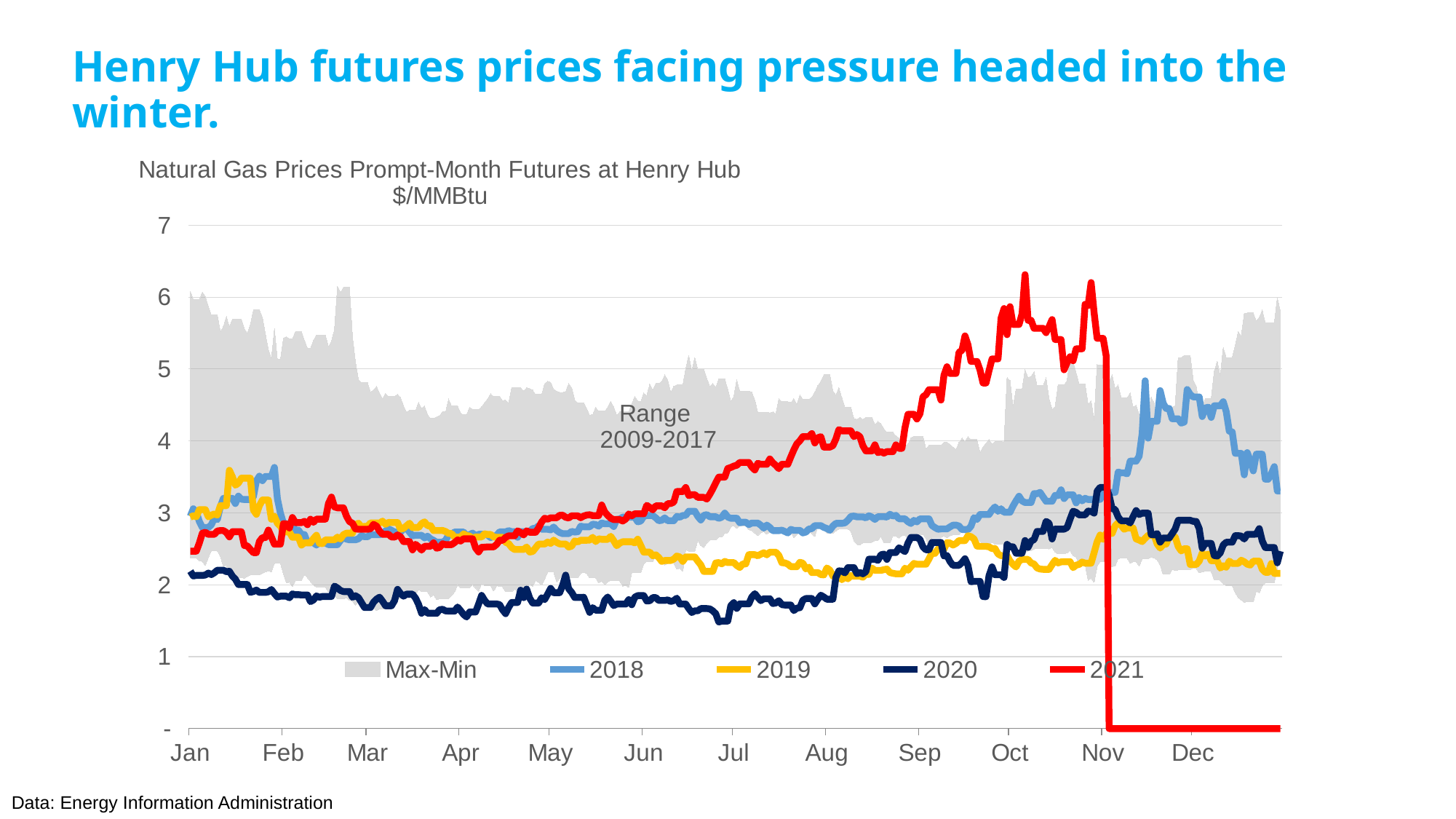
What is the unit shown under the chart title? $/MMBtu Is the value of the 2018 line in early December greater or less than 4? greater Is the peak value of the 2021 line in October greater or less than 6? greater How many months are labelled along the x axis? 12 Is the value of the 2020 line in January greater or less than 3? less Which years does the shaded Max-Min range cover, according to the label on the chart? 2009-2017 Does the 2021 line rise or fall from April to October? rise Which series reaches the highest value on the chart? 2021 In September, which line is higher, 2021 or 2020? 2021 How many entries does the chart legend list? 5 What kind of chart is shown on the slide? line chart